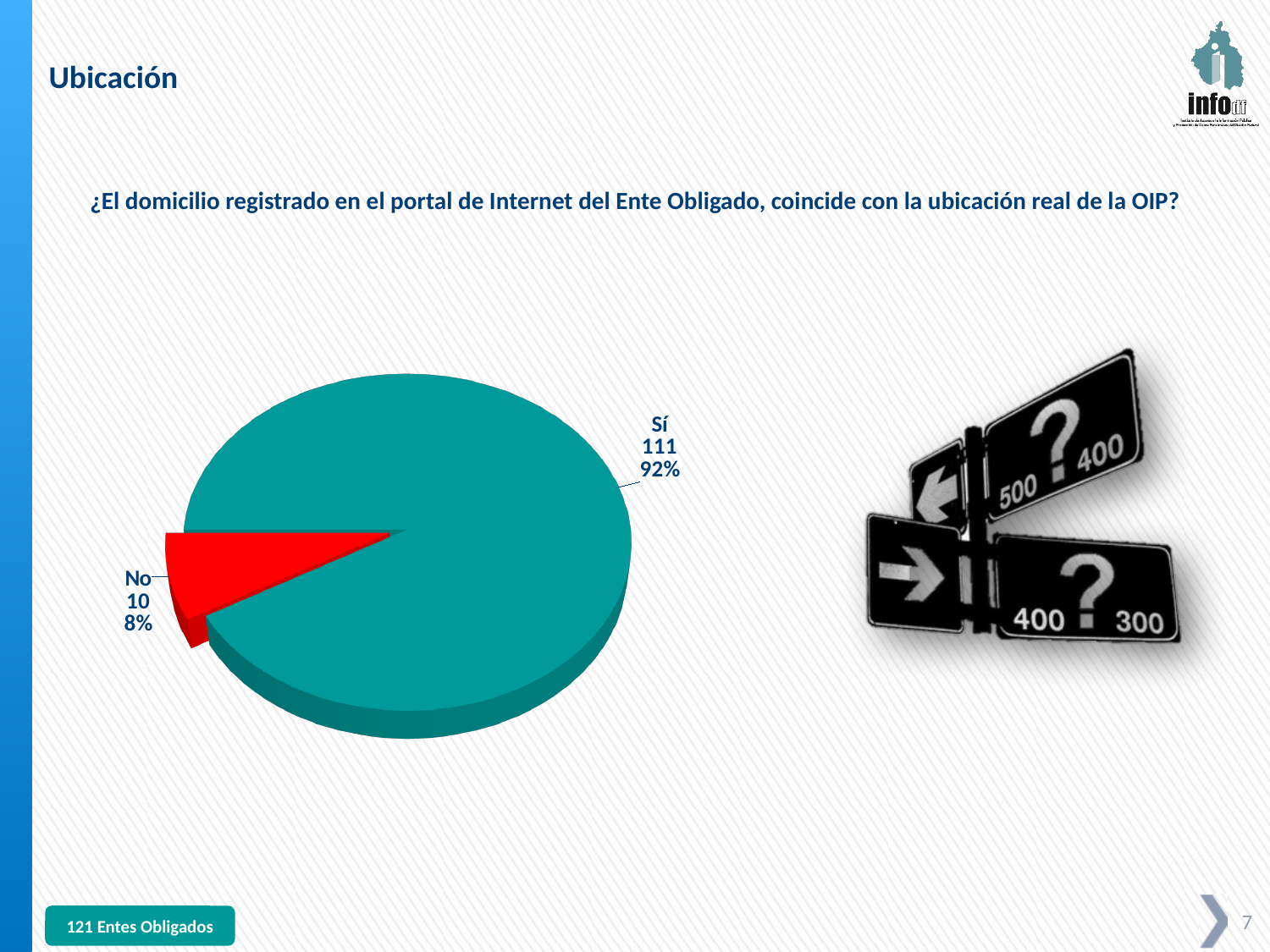
Which slice is the largest? Sí How many slices does the pie chart have? 2 What is the total of the two slice counts? 121 What is the count for the "Sí" slice? 111 What percentage share does the "No" slice represent? 8% What is the difference between the counts for "Sí" and "No"? 101 What kind of chart is shown on the slide? pie chart What colour is the "No" slice? red What percentage share does the "Sí" slice represent? 92% Which slice is the smallest? No Which is larger, the count for "Sí" or the count for "No"? Sí What is the count for the "No" slice? 10